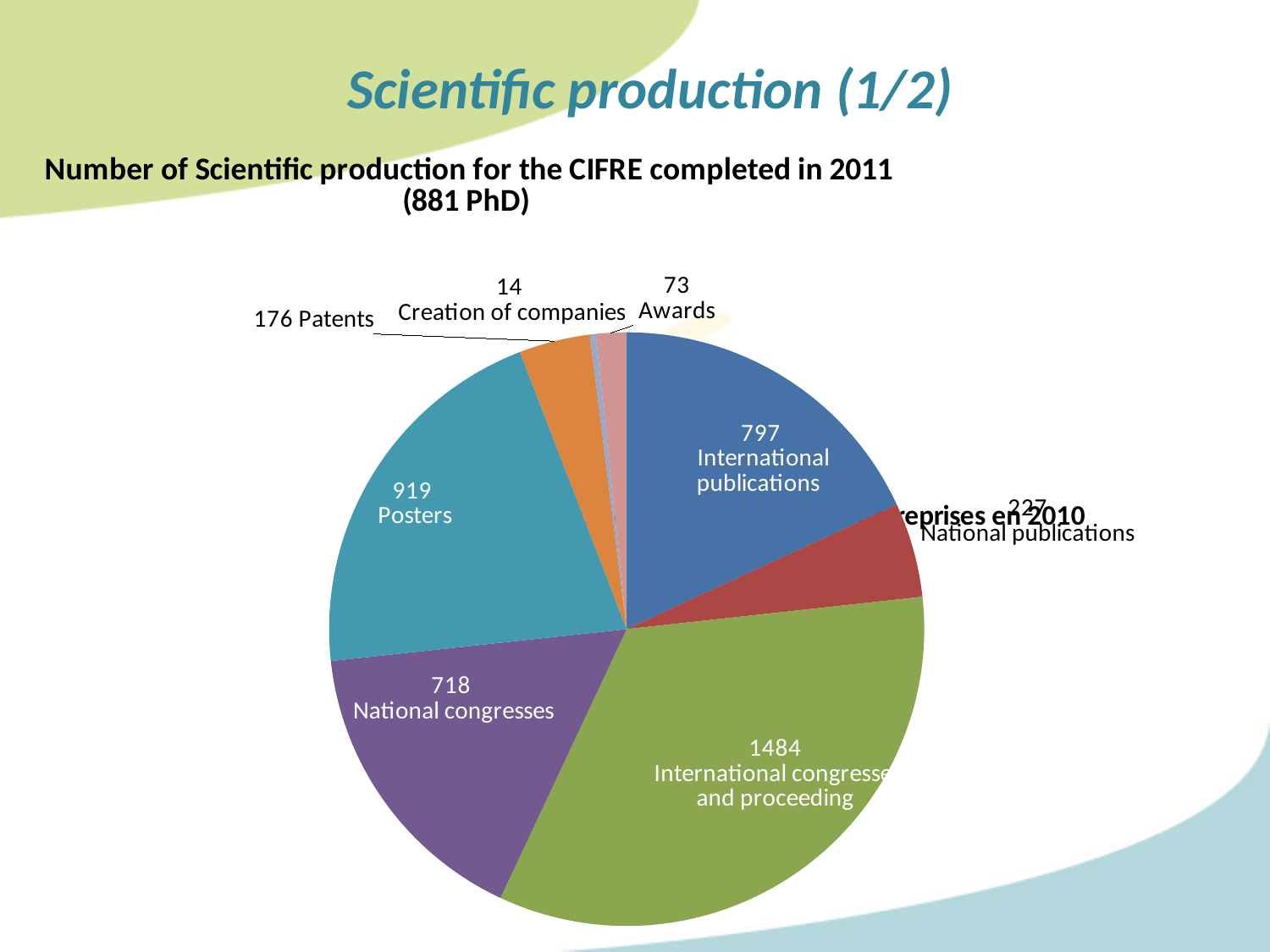
What is the value for International congresses and proceeding? 1484 Which is larger, International publications or National publications? International publications Which category has the largest slice of the pie? International congresses and proceeding What is the difference between the values for International congresses and proceeding and International publications? 687 Which category has the smallest slice of the pie? Creation of companies What is the value for International publications? 797 What is the value for Posters? 919 What is the difference between the values for Posters and National congresses? 201 What is the value for Patents? 176 How many slices does the pie chart have? 8 What type of chart is shown on the slide? Pie chart What is the title of the slide containing the pie chart? Scientific production (1/2)